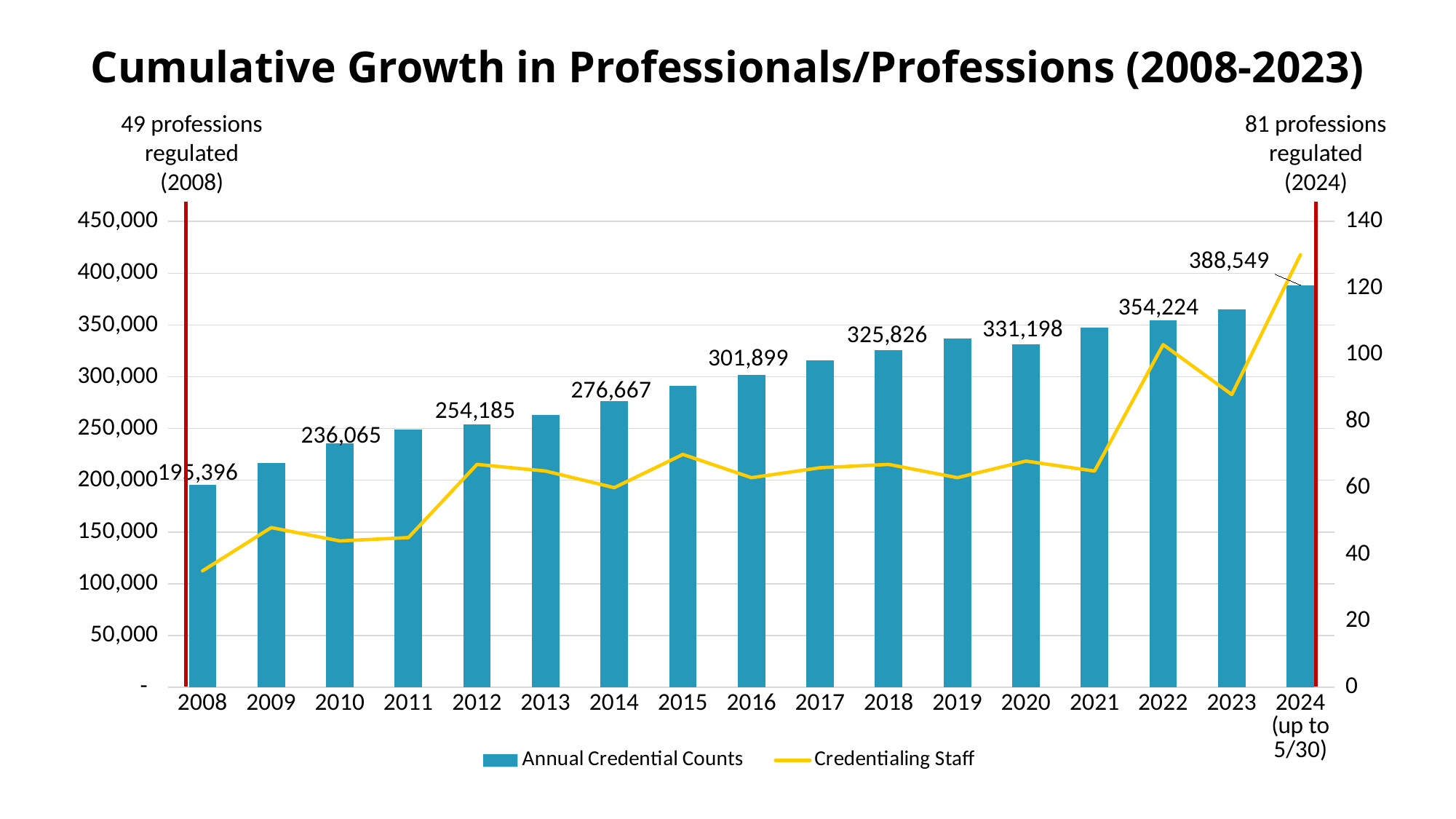
By how much did the Annual Credential Count grow from 2008 to 2016? 106,503 Which year has the lowest Annual Credential Count? 2008 Which year has the highest Annual Credential Count? 2024 Is the Annual Credential Count for 2015 greater or less than 300,000? less Which year has the larger Annual Credential Count, 2010 or 2014? 2014 What is the Annual Credential Count for 2018? 325,826 How many years are shown on the x axis? 17 How many series does the legend list? 2 What is the Annual Credential Count for 2012? 254,185 Is the Credentialing Staff value for 2024 greater or less than 120? greater What is the Annual Credential Count labelled for 2024 (up to 5/30)? 388,549 What is the difference between the Annual Credential Counts for 2022 and 2020? 23,026